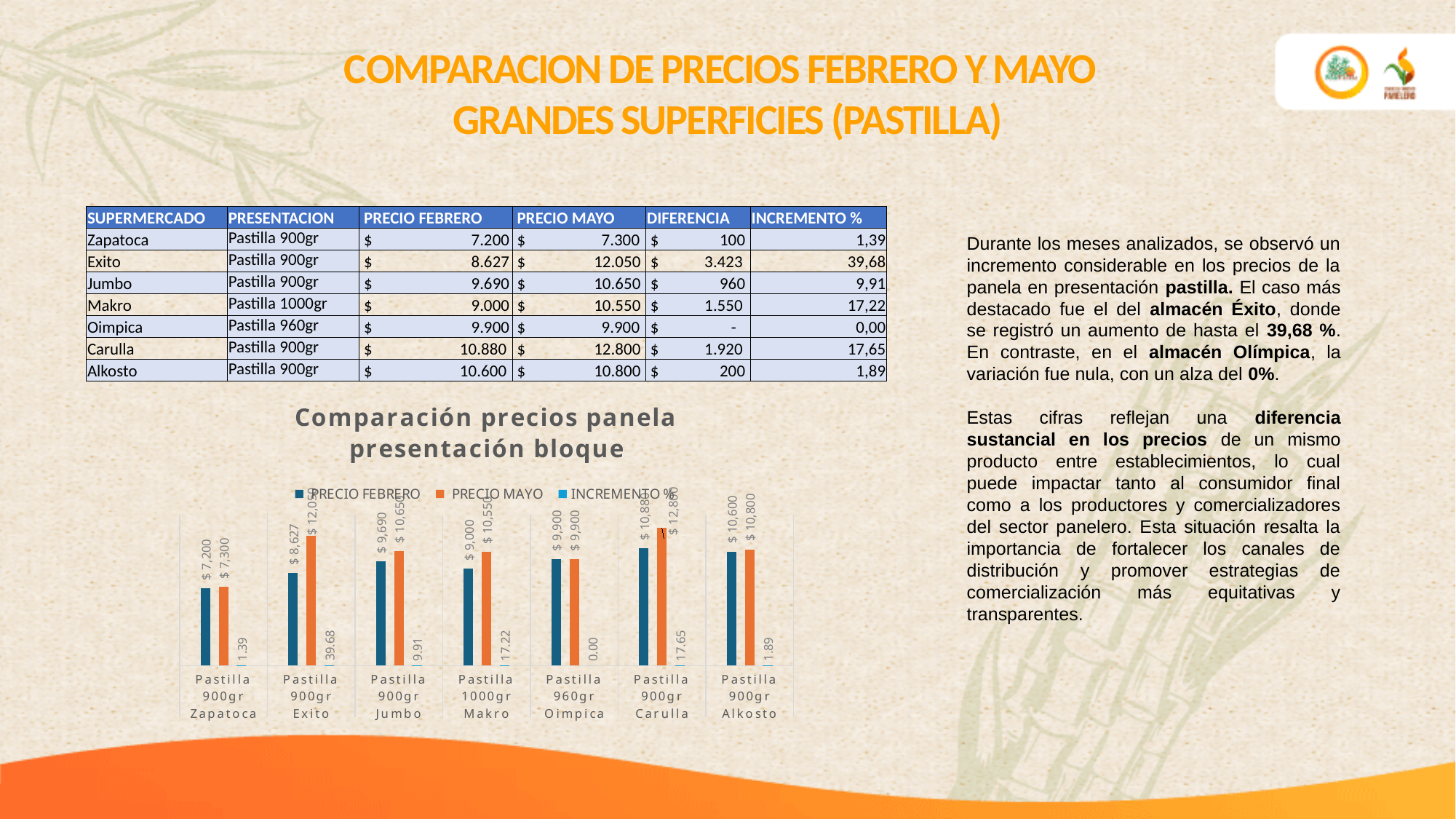
What is the INCREMENTO % value for Oimpica in the chart? 0.00 What is the PRECIO FEBRERO value for Zapatoca in the chart? $ 7,200 What is the PRECIO MAYO value for Zapatoca in the chart? $ 7,300 What is the title of the chart? Comparación precios panela presentación bloque How many series does the chart legend list? 3 Which supermarket has the lowest PRECIO FEBRERO in the chart? Zapatoca What type of chart is shown on the slide? bar chart Which is larger in the chart: the PRECIO FEBRERO for Carulla or the PRECIO FEBRERO for Makro? Carulla Which supermarket has the highest INCREMENTO % in the chart? Exito What is the PRECIO FEBRERO value for Carulla in the chart? $ 10,880 What is the INCREMENTO % value for Exito in the chart? 39.68 How many supermarket categories are shown on the x axis of the chart? 7